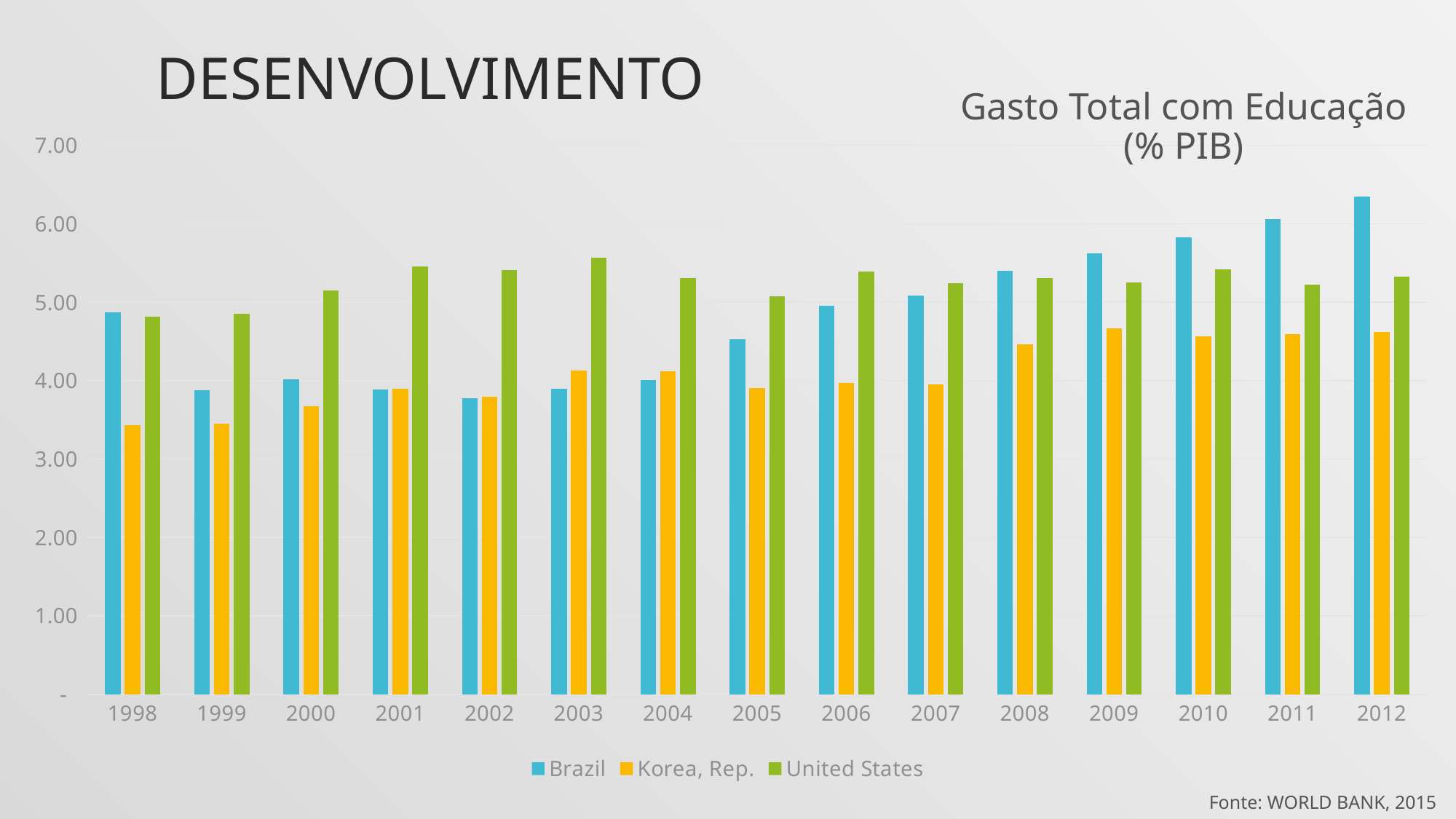
In 2005, which is larger: the value for Brazil or the value for United States? United States What is the title of the chart? Gasto Total com Educação (% PIB) How many series does the legend list? 3 Is the value for Korea, Rep. in 1998 greater or less than 4.00? less Do the values for Brazil rise or fall from 2005 to 2012? rise Is the value for United States in 2000 greater or less than 5.00? greater In which year is the value for Brazil highest? 2012 In which year is the value for United States highest? 2003 Is the value for Brazil in 2012 greater or less than 6.00? greater How many years are shown on the x axis? 15 In 2012, which is larger: the value for Brazil or the value for United States? Brazil What kind of chart is shown on the slide? Bar chart